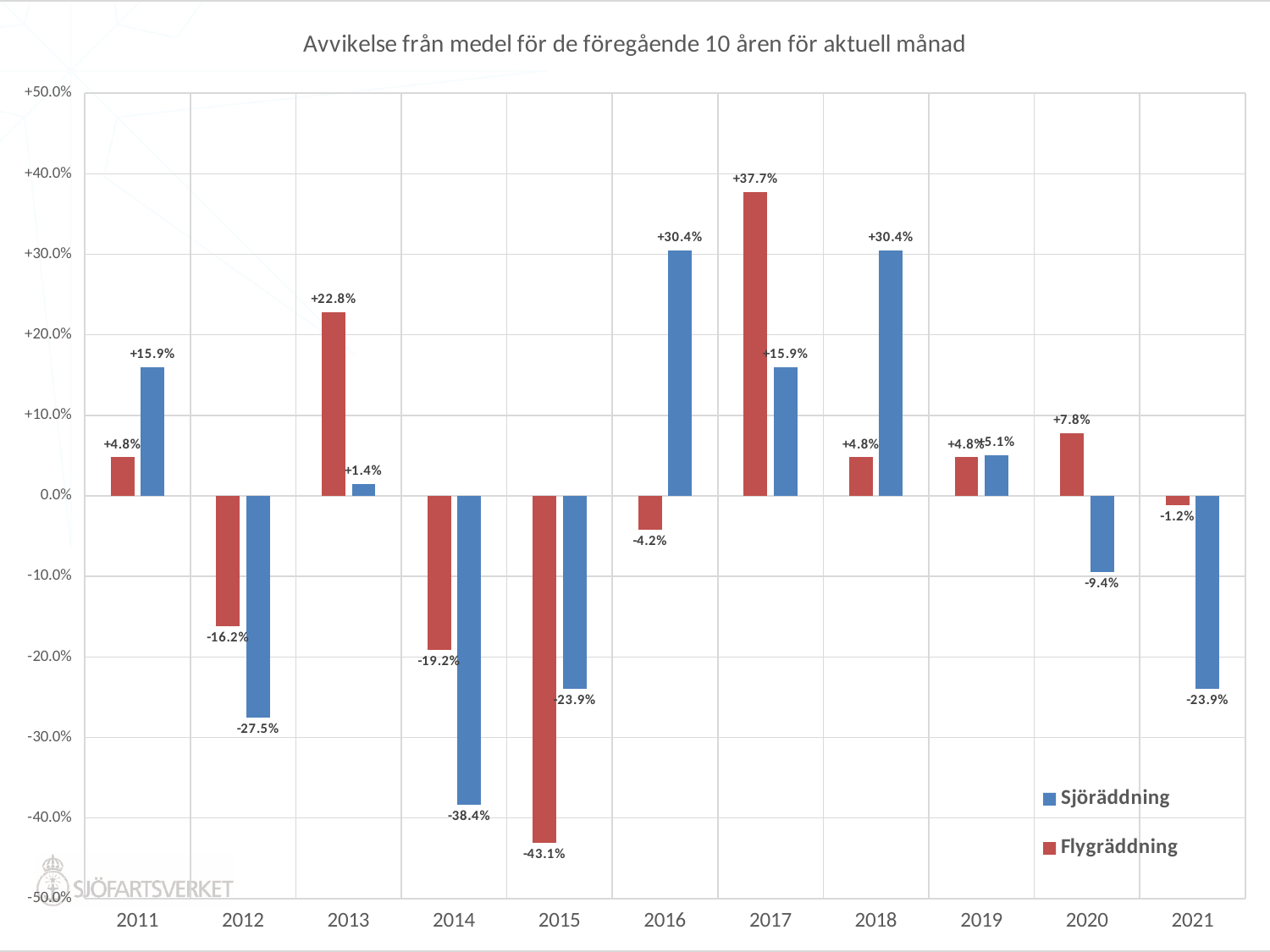
What is the Flygräddning value for 2020? +7.8% Which series has the larger value in 2013, Sjöräddning or Flygräddning? Flygräddning In which year is the Sjöräddning value lowest? 2014 How many series does the legend list? 2 What is the Sjöräddning value for 2016? +30.4% In which year is the Flygräddning value highest? 2017 How many years are shown on the x axis? 11 What kind of chart is shown on the slide? Bar chart What is the Flygräddning value for 2015? -43.1% Which colour represents Flygräddning in the chart? Red What is the Sjöräddning value for 2014? -38.4% What is the difference between the Flygräddning and Sjöräddning values in 2012? 11.3 percentage points